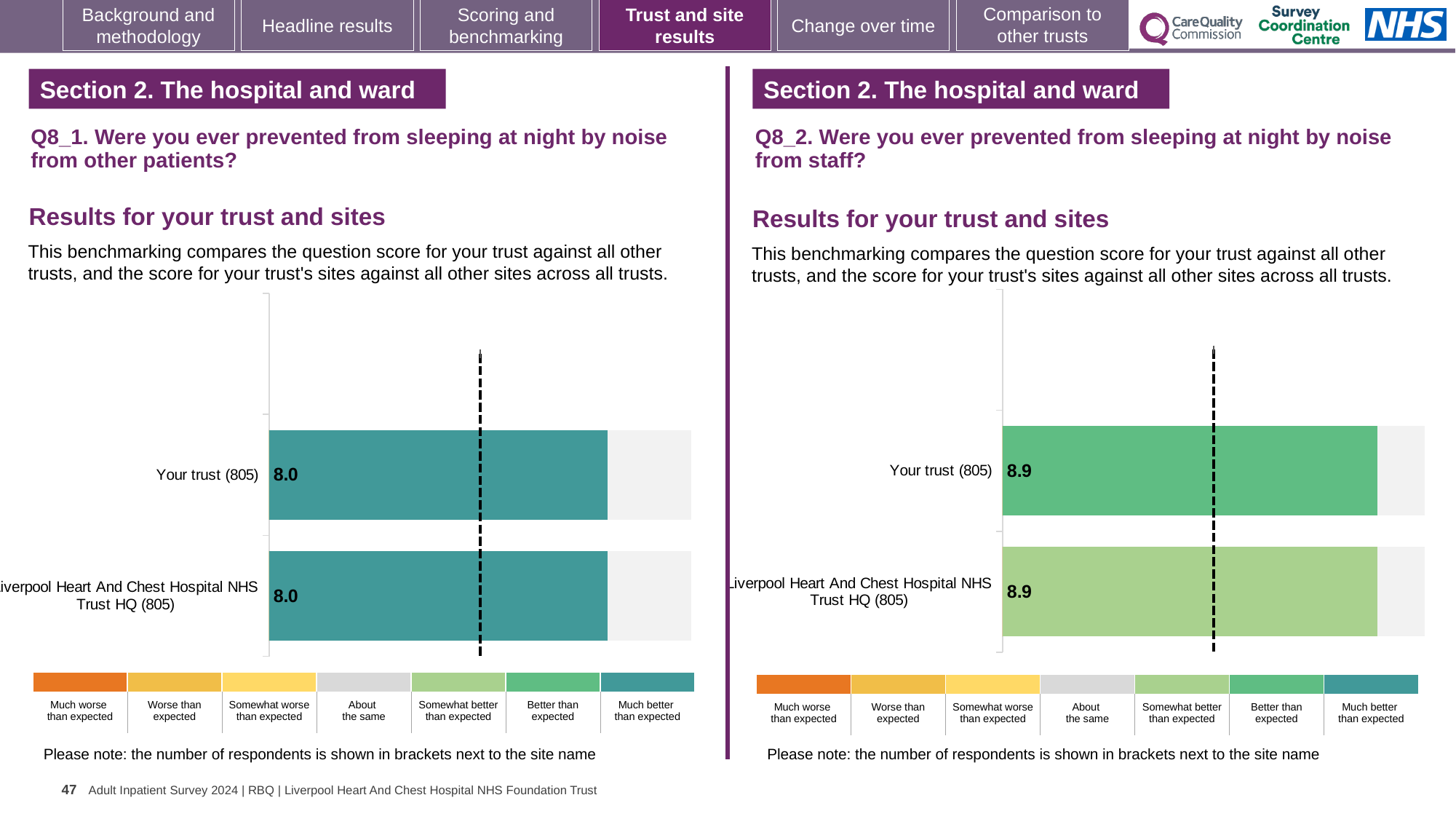
In the Q8_1 chart (left), which benchmark category does the colour of the Your trust (805) bar correspond to in the legend? Much better than expected In the Q8_1 chart (left), what is the score for Liverpool Heart And Chest Hospital NHS Trust HQ (805)? 8.0 In the Q8_2 chart (right), what is the score for Liverpool Heart And Chest Hospital NHS Trust HQ (805)? 8.9 How many bars are plotted in the Q8_1 chart (left)? 2 In the Q8_2 chart (right), which benchmark category does the colour of the Liverpool Heart And Chest Hospital NHS Trust HQ (805) bar correspond to in the legend? Somewhat better than expected What is the difference between the Your trust (805) score in the Q8_2 chart (right) and the Your trust (805) score in the Q8_1 chart (left)? 0.9 Which is larger: the Your trust (805) score in the Q8_2 chart (right) or the Your trust (805) score in the Q8_1 chart (left)? Q8_2 chart (right) What kind of chart is used for the Q8_2 results (right)? Bar chart In the Q8_2 chart (right), what is the score for Your trust (805)? 8.9 In the Q8_1 chart (left), what is the score for Your trust (805)? 8.0 How many bars are plotted in the Q8_2 chart (right)? 2 In the Q8_1 chart (left), what is the difference between the score for Your trust (805) and the score for Liverpool Heart And Chest Hospital NHS Trust HQ (805)? 0.0